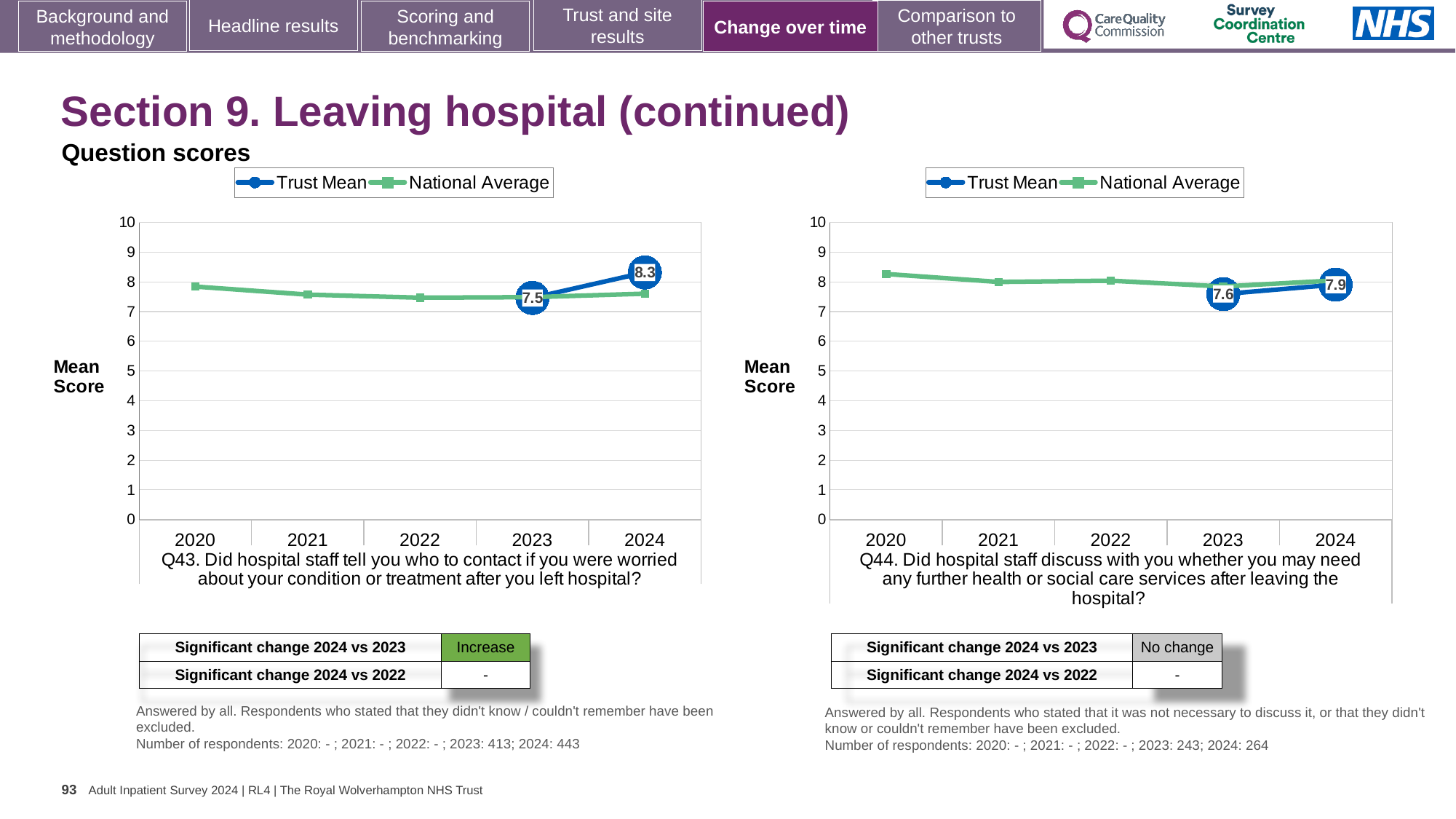
In the Q43 chart (left), which is higher in 2024, the Trust Mean or the National Average? Trust Mean In the Q43 chart (left), what is the Trust Mean score for 2024? 8.3 How many years are shown on the x axis of the Q43 chart (left)? 5 In the Q44 chart (right), what is the Trust Mean score for 2024? 7.9 What type of chart is used for Q44 (right)? Line chart In the Q44 chart (right), what is the Trust Mean score for 2023? 7.6 In the Q44 chart (right), is the National Average for 2020 greater or less than 8? greater In the Q43 chart (left), by how much did the Trust Mean change from 2023 to 2024? 0.8 How many series does the legend of the Q44 chart (right) list? 2 In the Q44 chart (right), what is the difference between the Trust Mean in 2024 and in 2023? 0.3 In the Q43 chart (left), what is the Trust Mean score for 2023? 7.5 In the Q43 chart (left), is the Trust Mean for 2024 greater or less than 8? greater